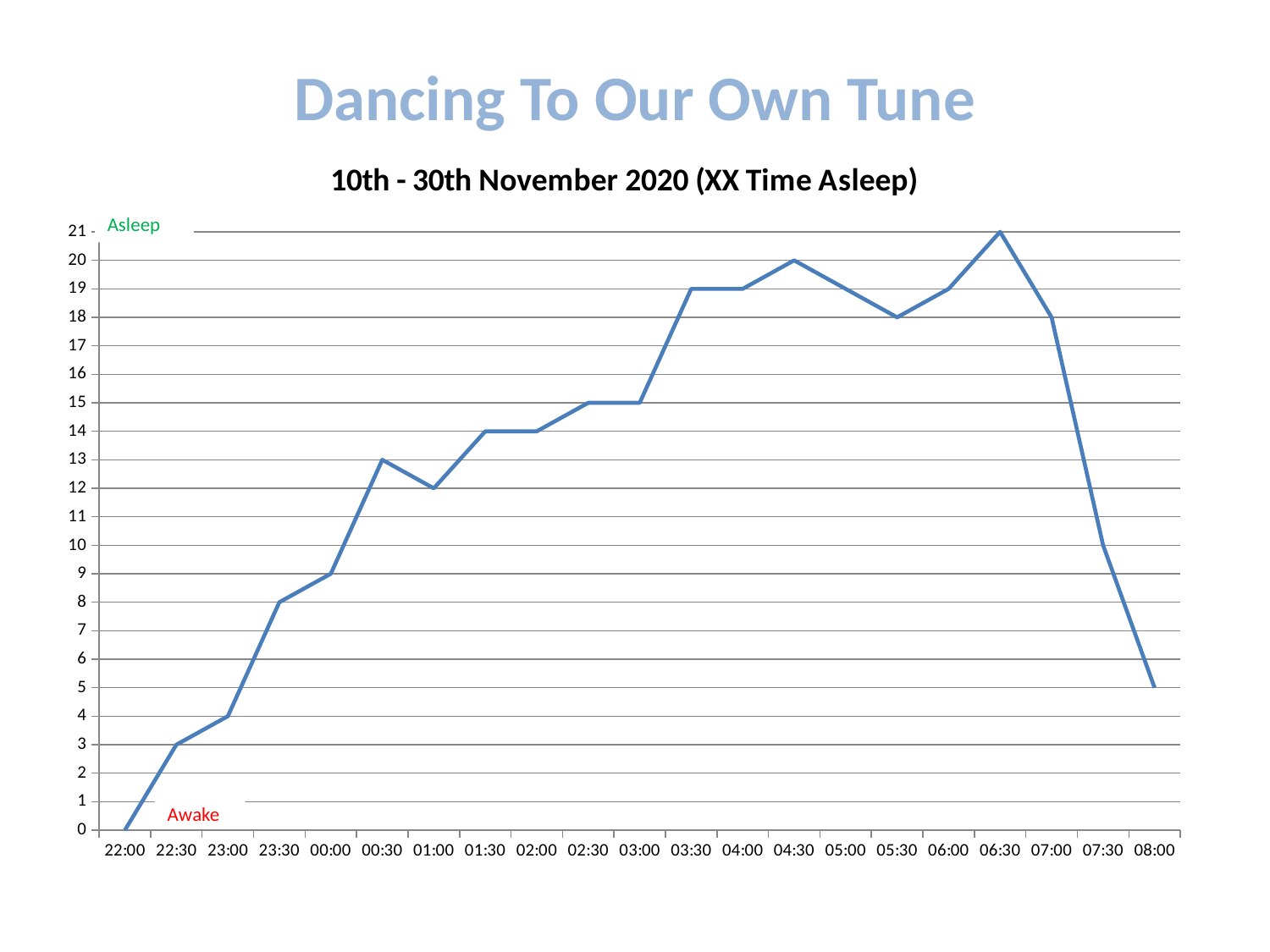
What is the value at 06:30? 21 Which is larger, the value at 00:30 or the value at 01:00? 00:30 Is the value at 23:30 greater or less than 10? less What is the difference between the values at 07:00 and 07:30? 8 How many time points are plotted along the x axis? 21 What kind of chart is shown on the slide? line chart At which time is the value lowest? 22:00 What is the chart's title? 10th - 30th November 2020 (XX Time Asleep) At which time does the line reach its highest value? 06:30 Does the line rise or fall between 06:30 and 08:00? fall What is the value at 04:30? 20 What is the value at 08:00? 5